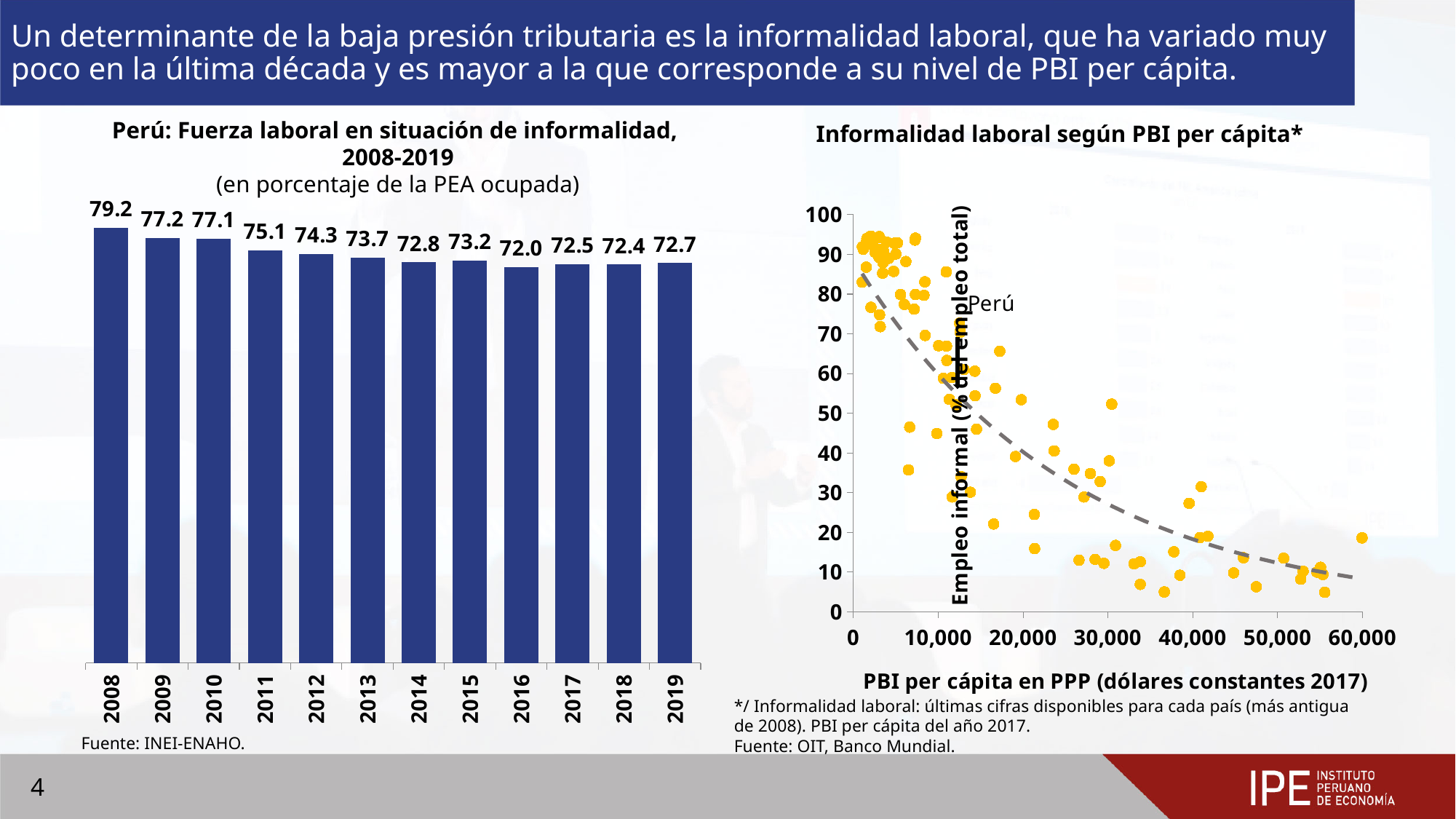
In the chart 'Perú: Fuerza laboral en situación de informalidad, 2008-2019', what is the value for 2008? 79.2 What kind of chart is 'Informalidad laboral según PBI per cápita*'? Scatter chart What kind of chart is 'Perú: Fuerza laboral en situación de informalidad, 2008-2019'? Bar chart In the chart 'Perú: Fuerza laboral en situación de informalidad, 2008-2019', which is larger, the value for 2014 or the value for 2015? 2015 In the chart 'Perú: Fuerza laboral en situación de informalidad, 2008-2019', which year has the highest value? 2008 In the chart 'Perú: Fuerza laboral en situación de informalidad, 2008-2019', do the values generally rise or fall from 2008 to 2019? Fall In the chart 'Perú: Fuerza laboral en situación de informalidad, 2008-2019', which year has the lowest value? 2016 In the chart 'Informalidad laboral según PBI per cápita*', is the value for Perú on the vertical axis greater or less than 50? greater In the chart 'Perú: Fuerza laboral en situación de informalidad, 2008-2019', what is the value for 2019? 72.7 In the chart 'Perú: Fuerza laboral en situación de informalidad, 2008-2019', what is the difference between the 2008 and 2019 values? 6.5 In the chart 'Informalidad laboral según PBI per cápita*', what is the label of the horizontal axis? PBI per cápita en PPP (dólares constantes 2017) How many years are shown in the chart 'Perú: Fuerza laboral en situación de informalidad, 2008-2019'? 12